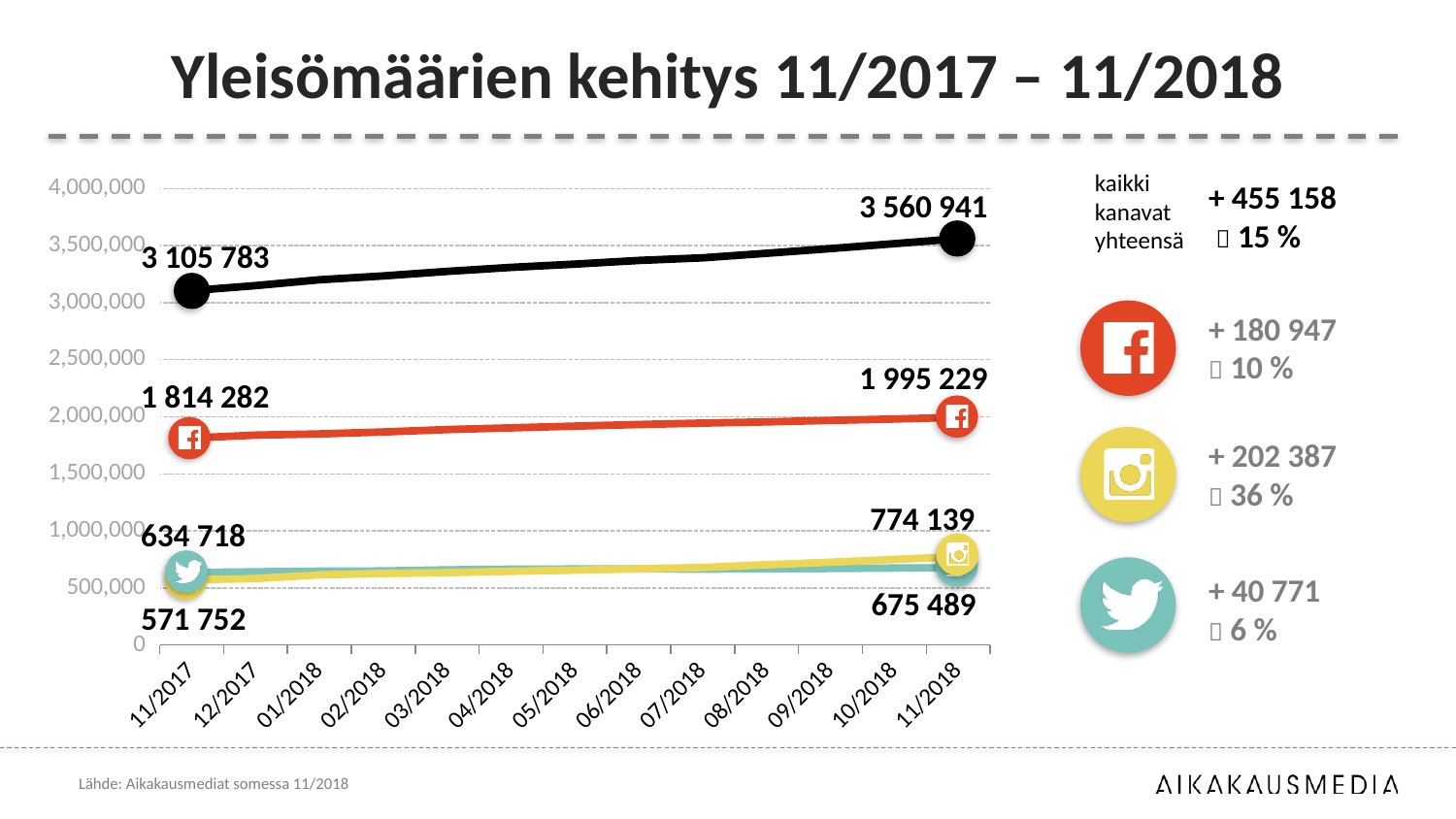
What is the value of the black (all channels total) line at 11/2018? 3 560 941 What is the value of the Twitter (teal) line at 11/2018? 675 489 What type of chart is shown on the slide? line chart What is the value of the black (all channels total) line at 11/2017? 3 105 783 By how much did the Facebook line increase from 11/2017 to 11/2018? 180 947 What is the value of the Facebook line at 11/2017? 1 814 282 By how much did the black (all channels total) line increase from 11/2017 to 11/2018? 455 158 How many months are shown on the x axis? 13 What is the value of the Facebook line at 11/2018? 1 995 229 Which line is higher at 11/2018, Instagram (yellow) or Twitter (teal)? Instagram (yellow) Does the black (all channels total) line rise or fall from 11/2017 to 11/2018? rise What is the value of the Instagram (yellow) line at 11/2018? 774 139